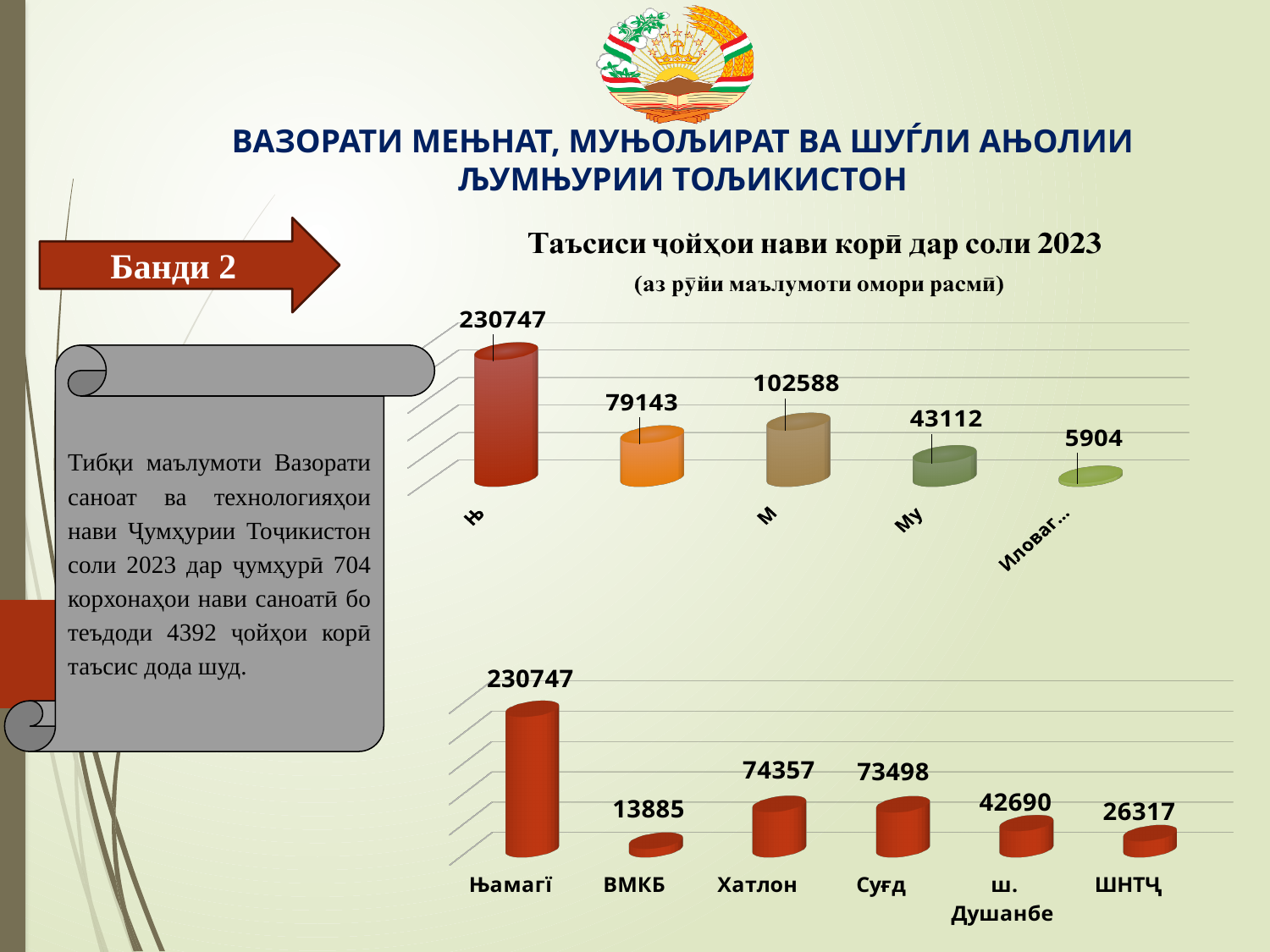
In the bottom chart, which category has the lowest value? ВМКБ In the bottom chart, what is the value for Хатлон? 74357 In the bottom chart, what is the value for ВМКБ? 13885 In the bottom chart, what is the difference between the values for Хатлон and Суғд? 859 In the bottom chart, which category has the highest value? Њамагї What is the value of the tallest bar in the top chart? 230747 What is the value of the smallest bar in the top chart? 5904 In the bottom chart, which is larger, the value for ш. Душанбе or the value for ШНТҶ? ш. Душанбе In the bottom chart, what is the value for ш. Душанбе? 42690 How many categories are shown in the bottom chart? 6 In the bottom chart, what is the value for ШНТҶ? 26317 What type of chart is the bottom chart? bar chart